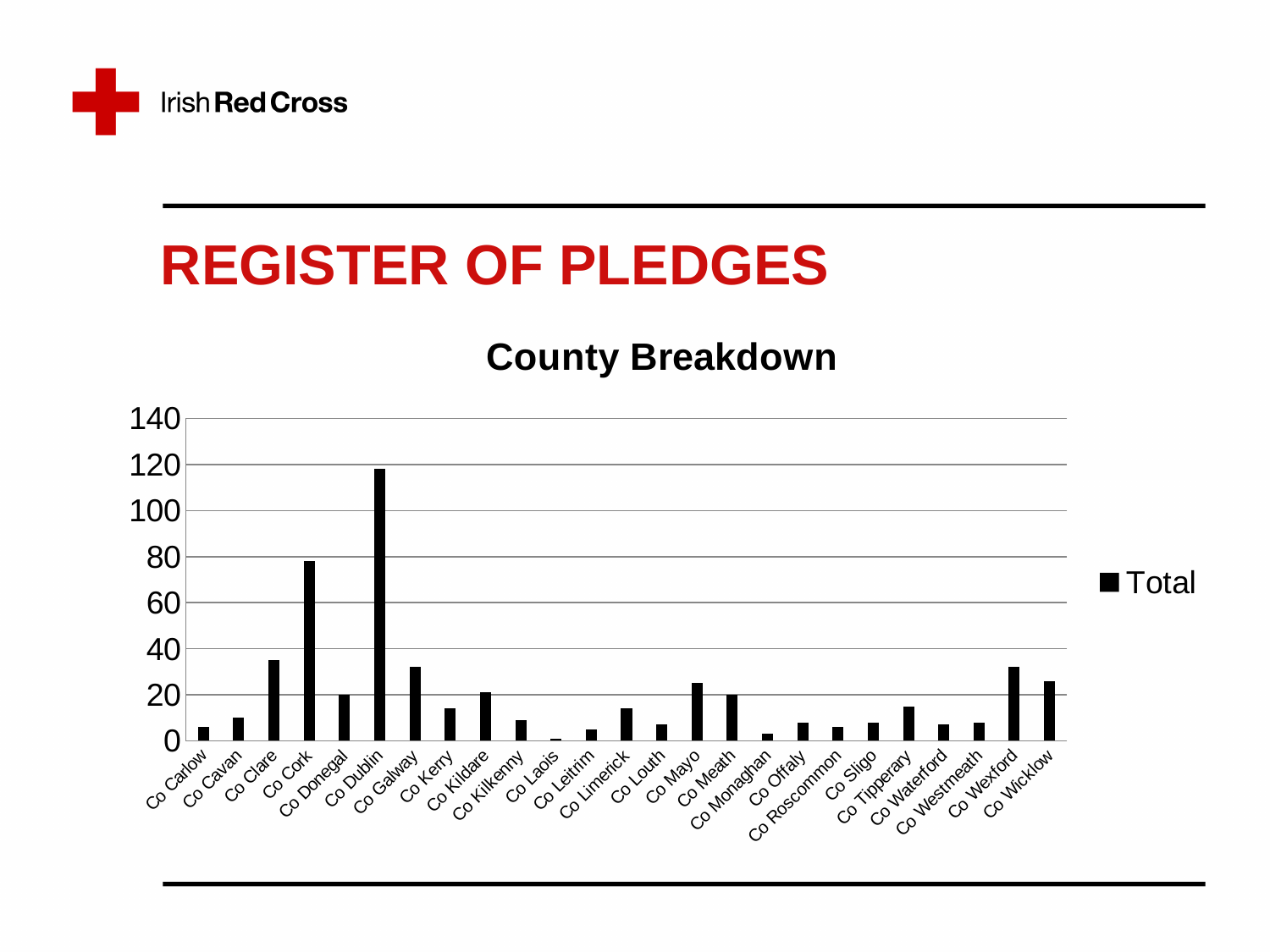
Is the value for Co Clare greater or less than 40? less What is the name of the series shown in the legend? Total What is the title of the chart? County Breakdown Which county has the highest total? Co Dublin Which county has the lowest total? Co Laois How many series does the legend list? 1 Is the value for Co Galway greater or less than 20? greater Is the value for Co Cork greater or less than 60? greater Which has a larger total, Co Cork or Co Clare? Co Cork What kind of chart is shown on the slide? bar chart How many counties are shown on the x axis? 25